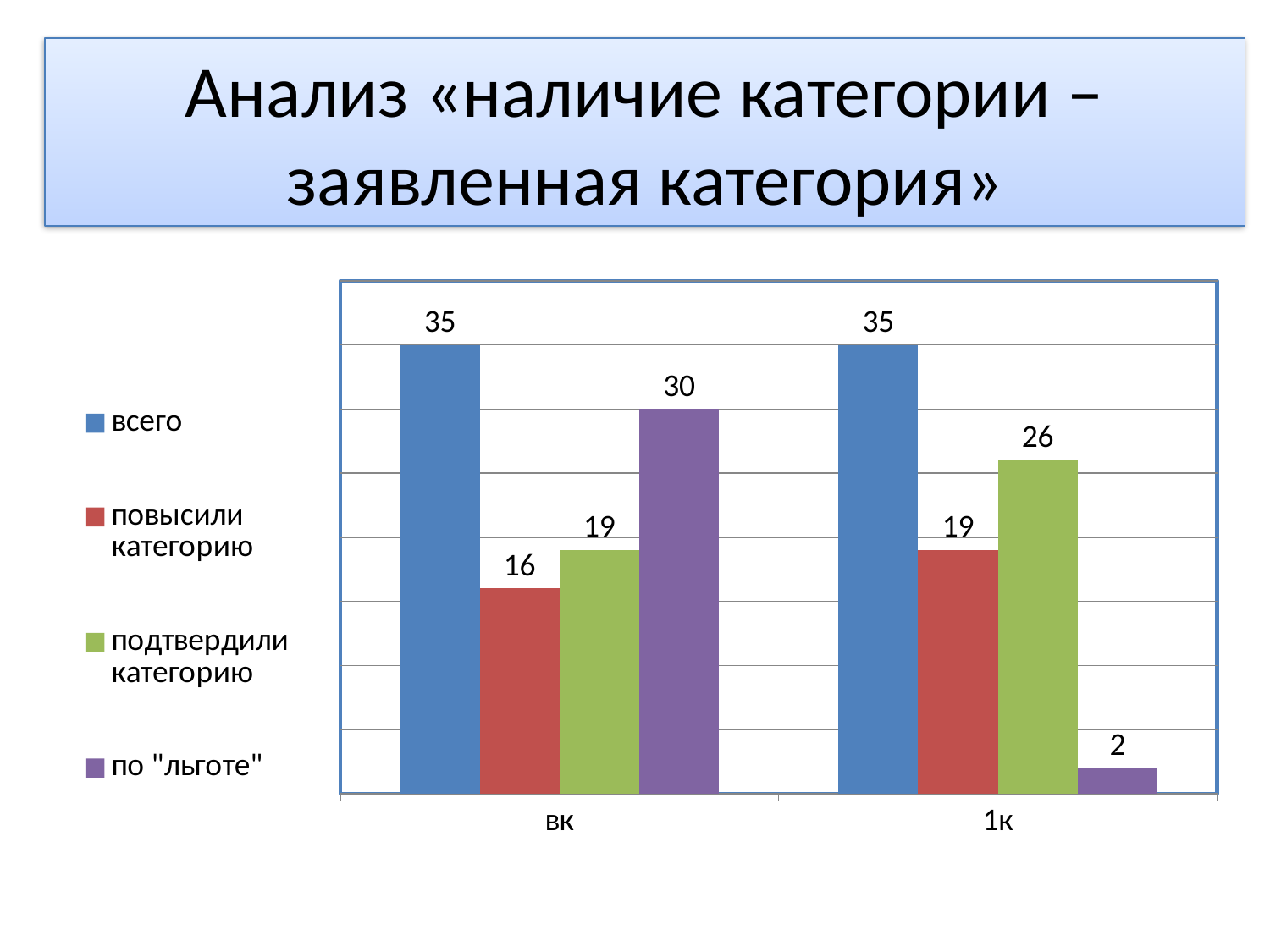
What is the difference between "по "льготе"" for "вк" and "по "льготе"" for "1к"? 28 Which series has the highest value for the category "вк"? всего What colour are the bars for the series "всего"? blue Which is larger: "подтвердили категорию" for "вк" or "подтвердили категорию" for "1к"? 1к How many series does the legend list? 4 What is the value of "повысили категорию" for the category "вк"? 16 Which series has the lowest value for the category "1к"? по "льготе" What is the value of "всего" for the category "вк"? 35 How many categories are shown on the x axis? 2 What kind of chart is shown on the slide? bar chart What is the value of "по "льготе"" for the category "1к"? 2 What is the value of "подтвердили категорию" for the category "1к"? 26